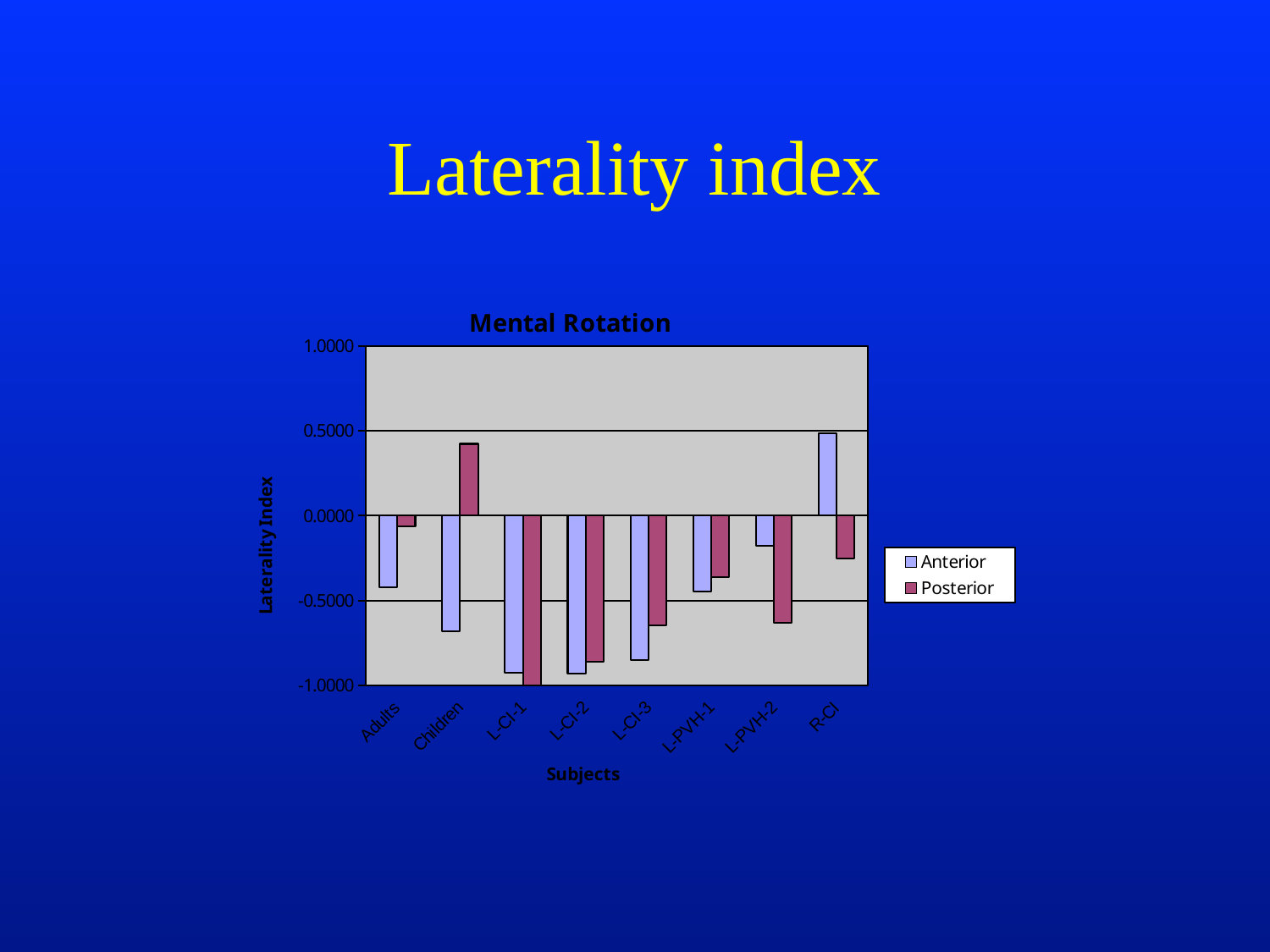
Which subject has the highest Posterior value? Children Is the Anterior value for Children greater or less than -0.5000? less What kind of chart is shown on the slide? bar chart Which subject has the lowest Posterior value? L-CI-1 How many subject categories are shown on the x axis of the Mental Rotation chart? 8 What is the label on the vertical axis of the chart? Laterality Index Is the Posterior value for Children greater or less than 0.0000? greater How many series does the legend of the Mental Rotation chart list? 2 For L-PVH-2, which is larger, the Anterior value or the Posterior value? Anterior What is the title of the chart? Mental Rotation Is the Posterior value for L-PVH-2 greater or less than -0.5000? less Which subject has the highest Anterior value? R-CI